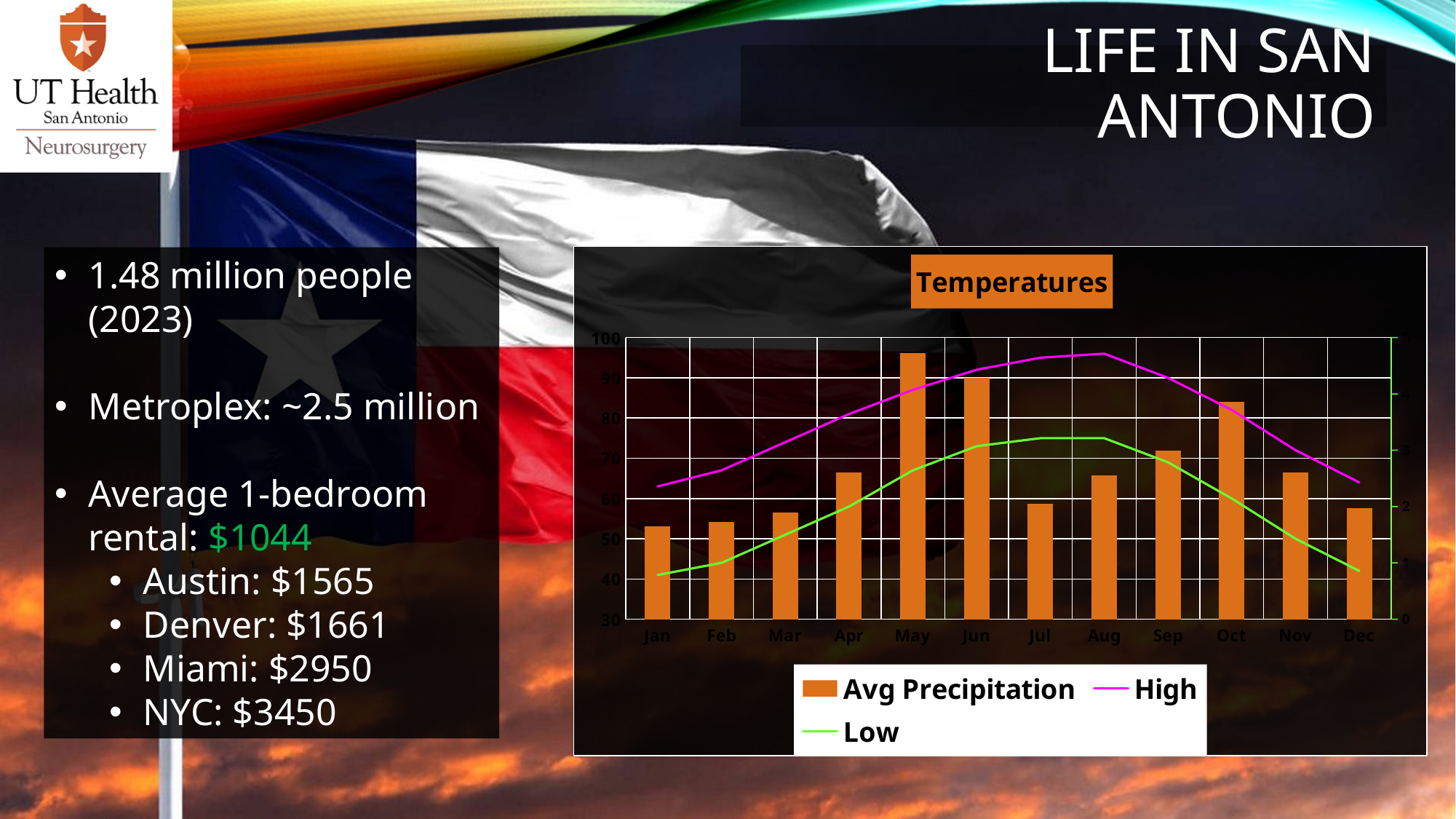
What kind of chart is shown on the slide? A combined bar and line chart Which month has the shortest Avg Precipitation bar? Jan Is the Avg Precipitation bar taller in May or in Jul? May Is the Low value for Jul greater or less than 70 on the left axis? greater Which series is drawn as a green line in the chart? Low Which month has the tallest Avg Precipitation bar? May What is the title of the chart? Temperatures Is the High value for Aug greater or less than 90 on the left axis? greater How many series does the chart legend list? 3 Does the Low line rise or fall from Aug to Dec? Falls Does the High line rise or fall from Jan to Aug? Rises How many months are plotted along the x axis of the chart? 12